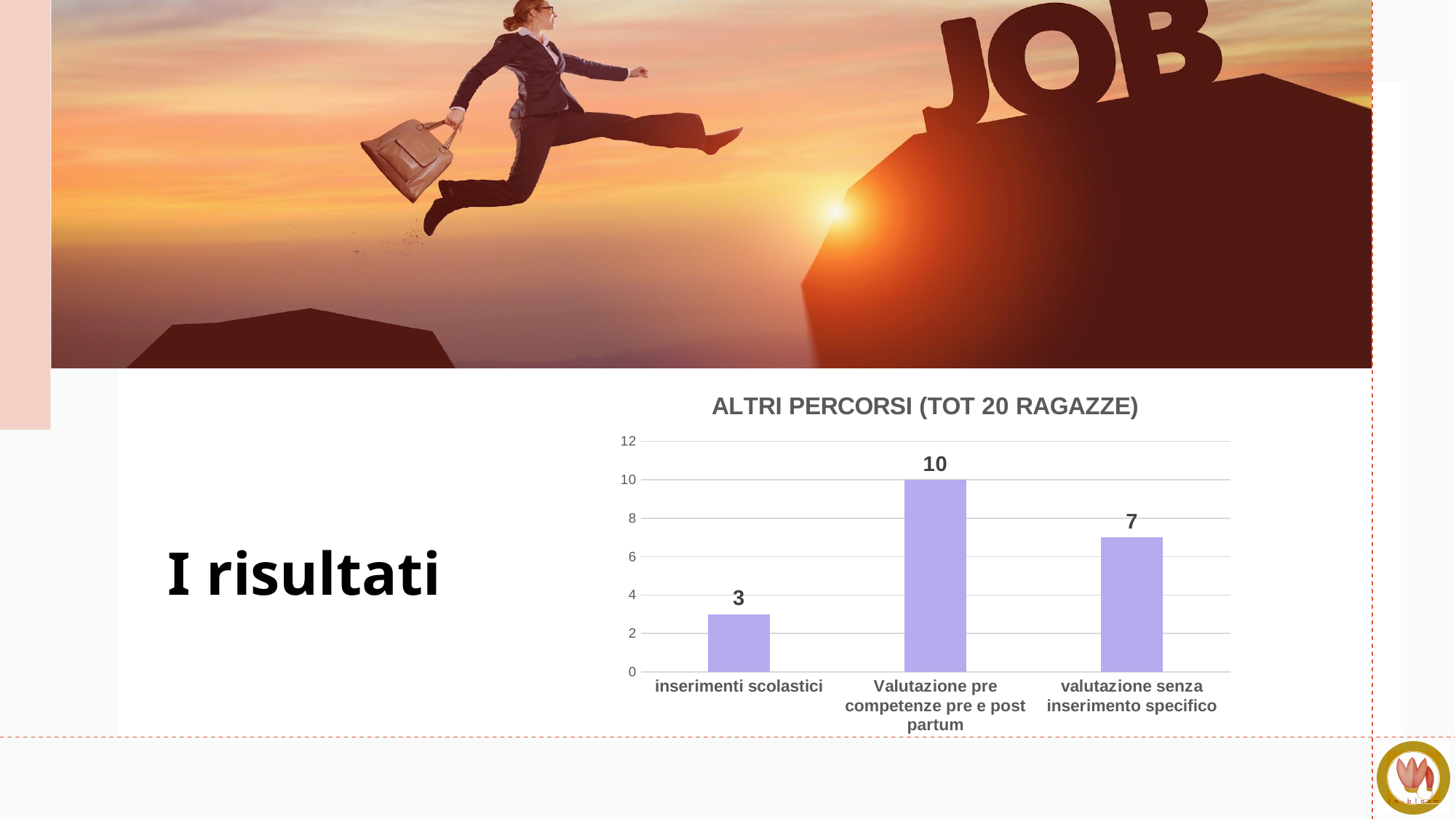
Which is larger, the value for 'inserimenti scolastici' or the value for 'valutazione senza inserimento specifico'? valutazione senza inserimento specifico What is the difference between the values for 'valutazione senza inserimento specifico' and 'inserimenti scolastici'? 4 What is the title of the chart? ALTRI PERCORSI (TOT 20 RAGAZZE) Which category has the highest value? Valutazione pre competenze pre e post partum What kind of chart is shown on the slide? bar chart What is the value for 'inserimenti scolastici'? 3 Which category has the lowest value? inserimenti scolastici Is the value for 'valutazione senza inserimento specifico' greater or less than 6? greater What is the value for 'Valutazione pre competenze pre e post partum'? 10 What is the difference between the values for 'Valutazione pre competenze pre e post partum' and 'valutazione senza inserimento specifico'? 3 What is the value for 'valutazione senza inserimento specifico'? 7 How many categories are shown in the chart? 3